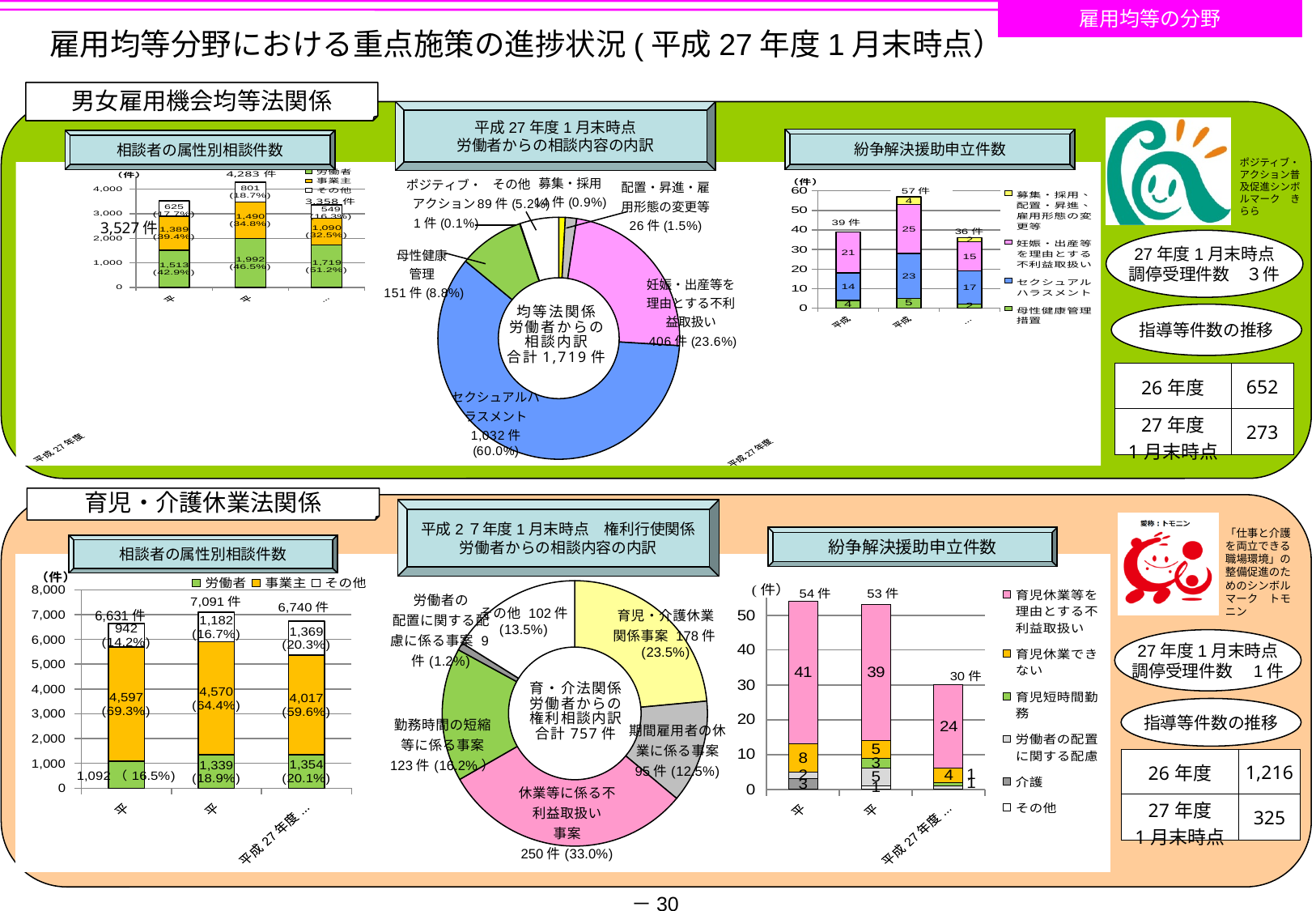
In the bottom donut chart (育・介法関係 労働者からの権利相談内訳), how many categories are shown? 6 In the bottom donut chart (育・介法関係 労働者からの権利相談内訳), what is the share of 育児・介護休業関係事案? 23.5% In the 紛争解決援助申立件数 bar chart in the bottom (育児・介護休業法関係) section, what is the value of the 育児休業等を理由とする不利益取扱い segment in the first bar? 41 In the 紛争解決援助申立件数 bar chart in the top (男女雇用機会均等法関係) section, what is the difference between the totals of the middle bar and the right bar? 21件 In the 紛争解決援助申立件数 bar chart in the bottom (育児・介護休業法関係) section, how many series does the legend list? 6 In the 相談者の属性別相談件数 bar chart in the bottom (育児・介護休業法関係) section, what is the 事業主 value in the first bar? 4,597 (69.3%) In the bottom donut chart (育・介法関係 労働者からの権利相談内訳), which category has the largest share? 休業等に係る不利益取扱い事案 (250件, 33.0%) In the top donut chart (均等法関係 労働者からの相談内訳), how many cases are for セクシュアルハラスメント? 1,032件 (60.0%) In the top donut chart (均等法関係 労働者からの相談内訳), what is the total number of cases shown in the centre? 合計 1,719件 In the 紛争解決援助申立件数 bar chart in the top (男女雇用機会均等法関係) section, what is the total of the middle bar? 57件 In the 相談者の属性別相談件数 bar chart in the bottom (育児・介護休業法関係) section, which bar has the highest total? The middle bar (7,091件) In the top donut chart (均等法関係 労働者からの相談内訳), which category has the smallest share? ポジティブ・アクション (1件, 0.1%)